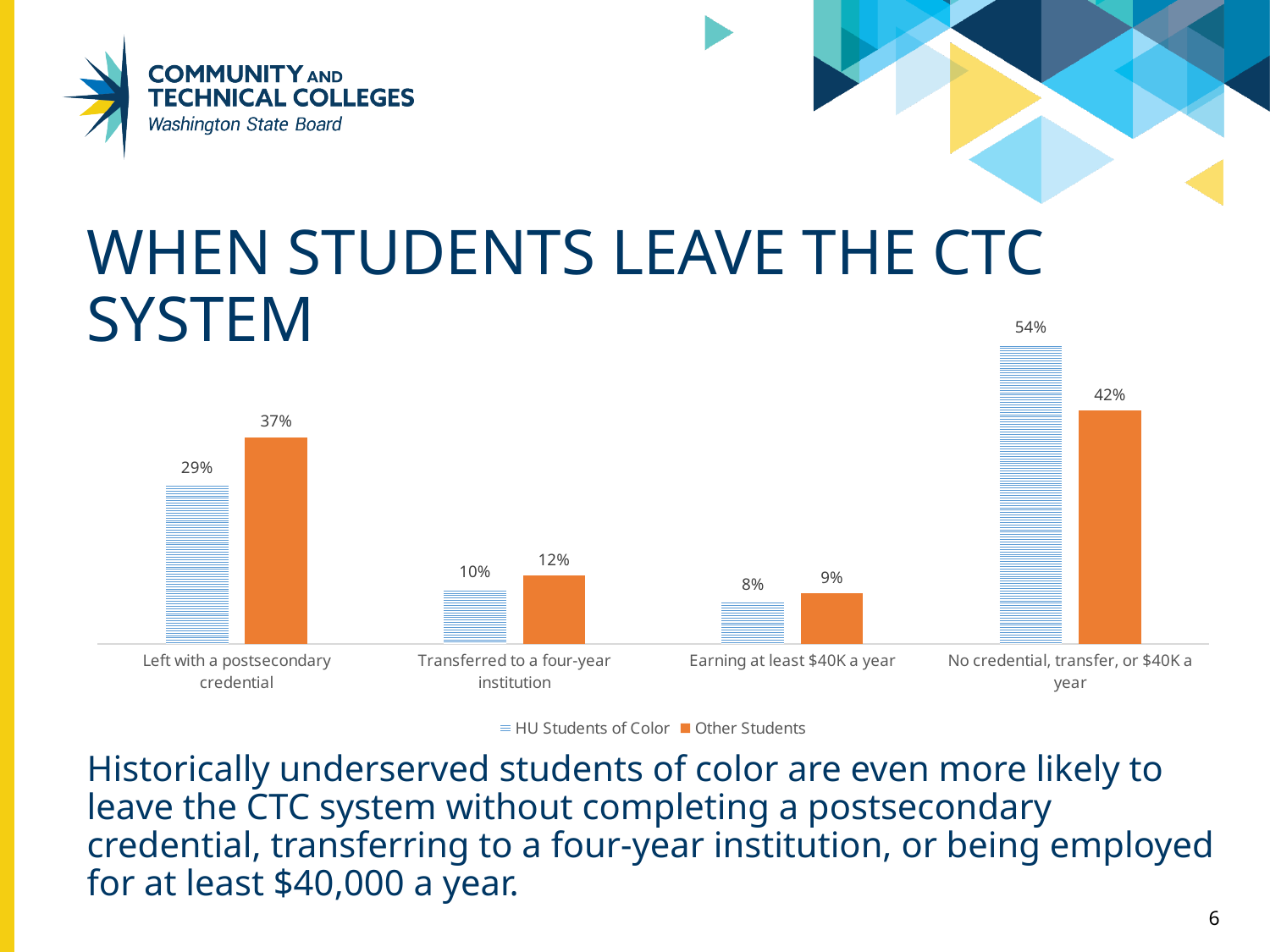
What is the value for HU Students of Color in the 'Left with a postsecondary credential' category? 29% Which category has the highest value for HU Students of Color? No credential, transfer, or $40K a year What kind of chart is shown on the slide? Bar chart How many categories are shown on the x axis of the chart? 4 What is the value for Other Students in the 'Transferred to a four-year institution' category? 12% What is the difference between HU Students of Color and Other Students in the 'No credential, transfer, or $40K a year' category? 12% How many series does the legend list? 2 Which category has the lowest value for Other Students? Earning at least $40K a year What is the value for HU Students of Color in the 'Earning at least $40K a year' category? 8% What is the value for Other Students in the 'No credential, transfer, or $40K a year' category? 42% What is the difference between Other Students and HU Students of Color in the 'Left with a postsecondary credential' category? 8% In the 'Transferred to a four-year institution' category, which series has the larger value? Other Students